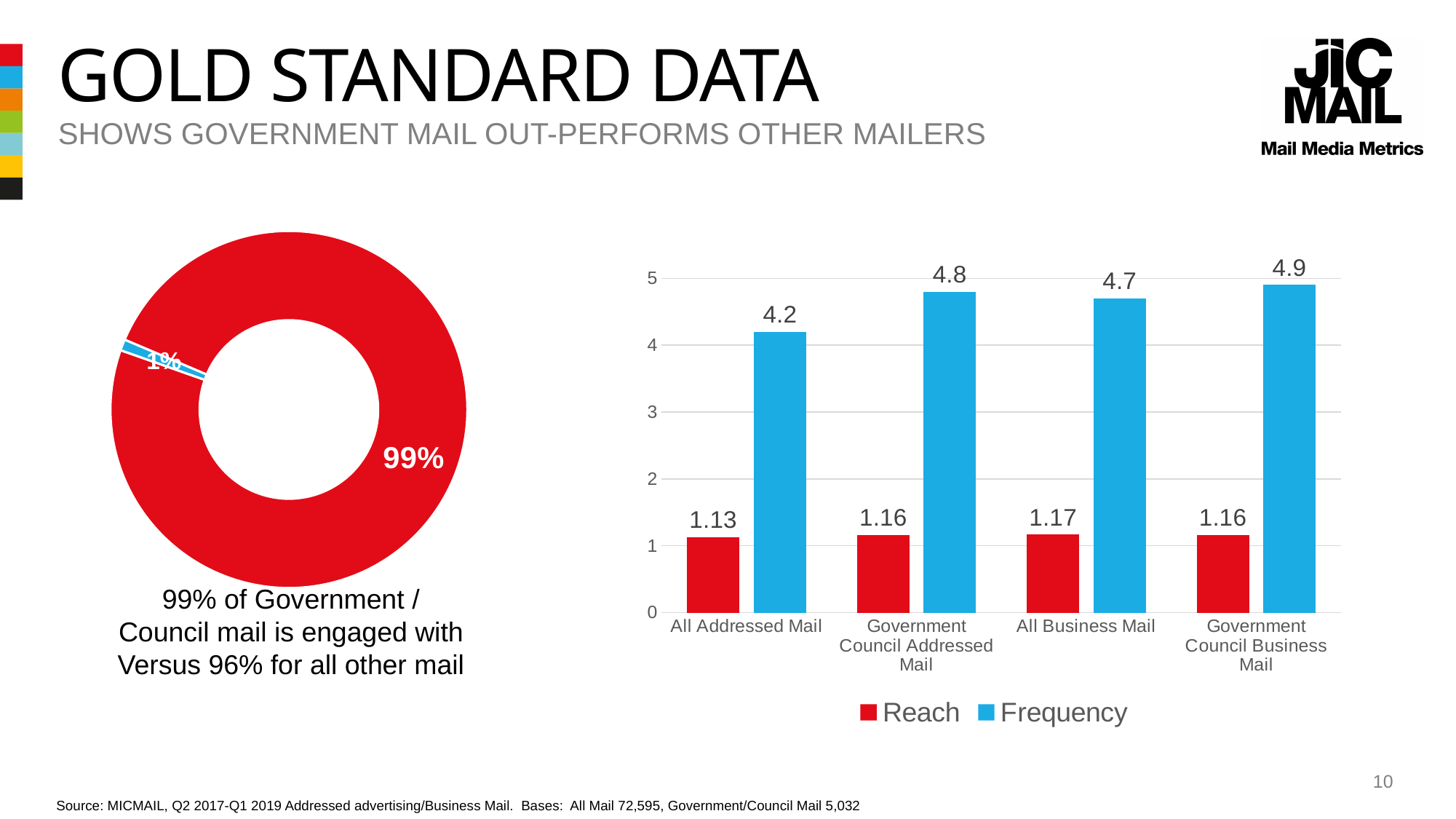
What kind of chart is shown on the right of the slide? Bar chart In the bar chart on the right, what is the difference between the Frequency values for Government Council Addressed Mail and All Addressed Mail? 0.6 In the bar chart on the right, what is the Frequency value for Government Council Business Mail? 4.9 In the donut chart on the left, what share does the red slice represent? 99% In the bar chart on the right, what is the Reach value for All Addressed Mail? 1.13 In the bar chart on the right, which category has the highest Frequency value? Government Council Business Mail In the bar chart on the right, how many series does the legend list? 2 In the bar chart on the right, which colour represents the Frequency series? Blue In the bar chart on the right, how many categories are shown on the x axis? 4 In the bar chart on the right, what is the Frequency value for All Business Mail? 4.7 In the bar chart on the right, which is larger: the Frequency for All Business Mail or the Frequency for Government Council Addressed Mail? Government Council Addressed Mail In the bar chart on the right, which category has the lowest Reach value? All Addressed Mail